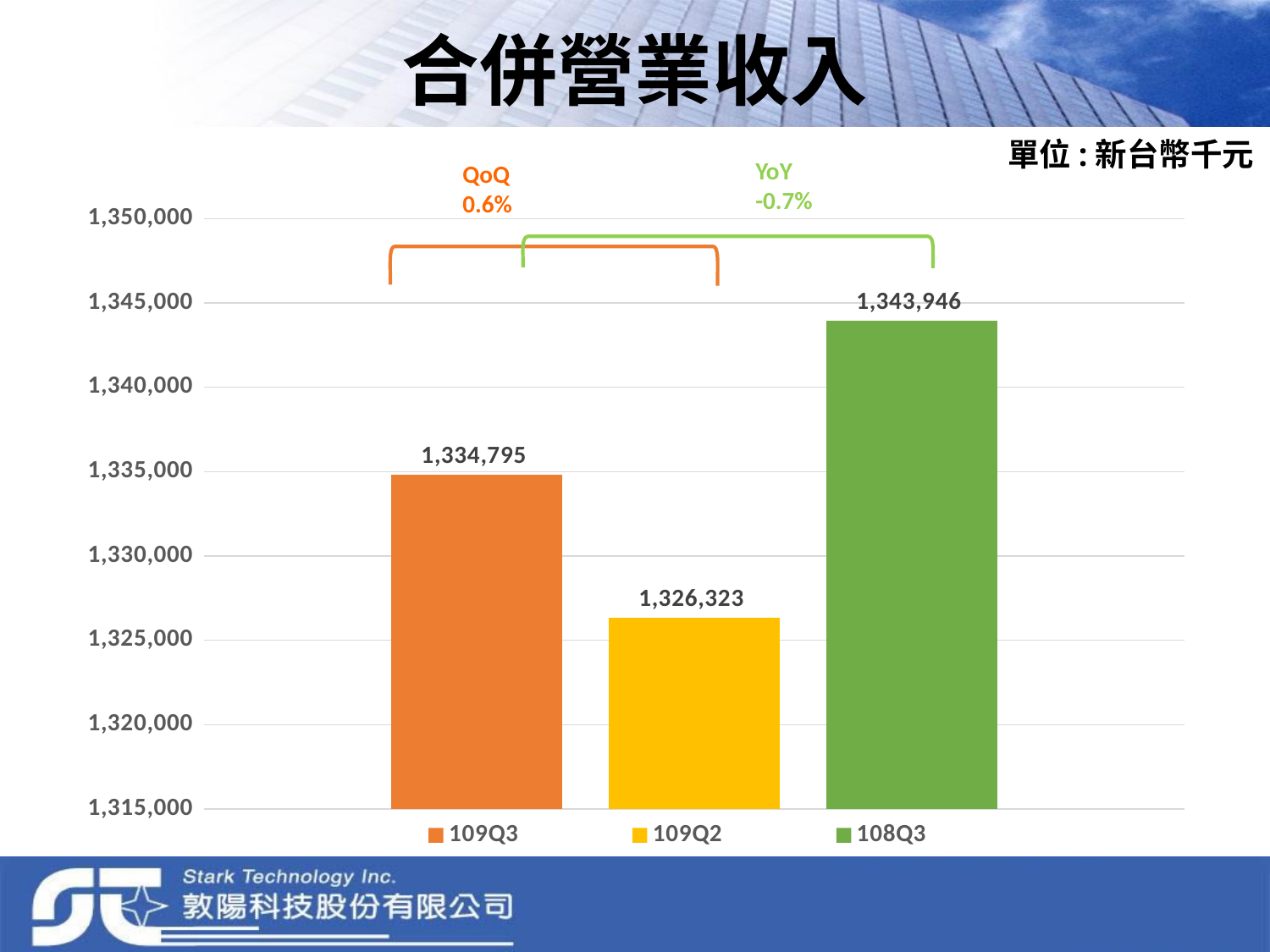
What is the difference between the 108Q3 value and the 109Q3 value? 9,151 Is the value for 108Q3 greater or less than 1,340,000? greater Which period has the lowest value in the chart? 109Q2 Which is larger, the value for 109Q3 or the value for 109Q2? 109Q3 How many bars are plotted in the chart? 3 What is the consolidated revenue value shown for 109Q3? 1,334,795 What is the difference between the 109Q3 value and the 109Q2 value? 8,472 What is the value shown for 109Q2? 1,326,323 What is the value shown for 108Q3? 1,343,946 What QoQ percentage change is annotated on the chart? 0.6% Which period has the highest value in the chart? 108Q3 What type of chart is shown on the slide? bar chart